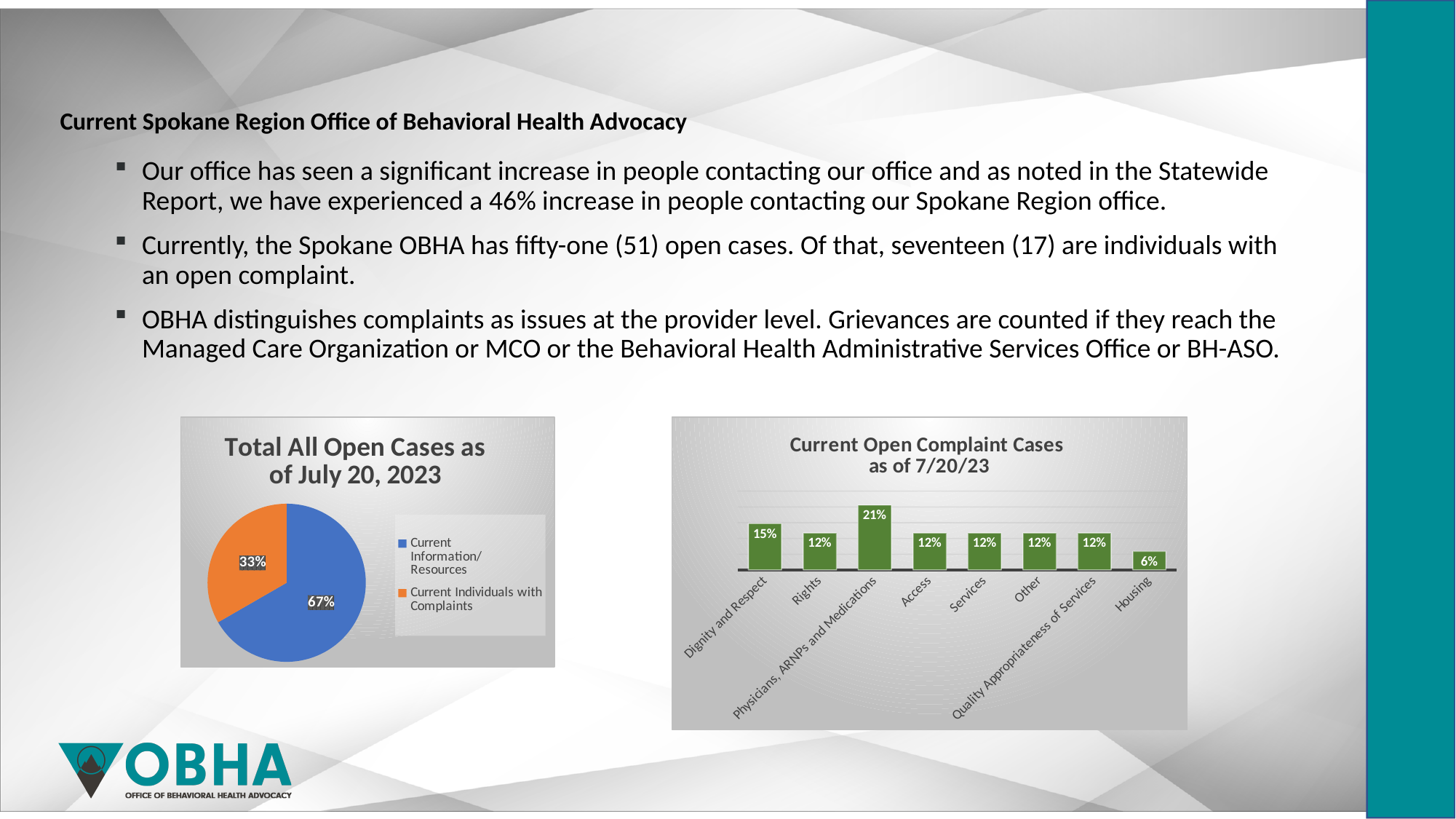
In the 'Current Open Complaint Cases as of 7/20/23' chart, which category has the highest value? Physicians, ARNPs and Medications How many categories are shown in the 'Current Open Complaint Cases as of 7/20/23' chart? 8 How many entries does the legend of the 'Total All Open Cases as of July 20, 2023' chart list? 2 What kind of chart is 'Total All Open Cases as of July 20, 2023'? Pie chart In the 'Total All Open Cases as of July 20, 2023' chart, what share of the pie is 'Current Individuals with Complaints'? 33% In the 'Current Open Complaint Cases as of 7/20/23' chart, what is the value for 'Dignity and Respect'? 15% In the 'Current Open Complaint Cases as of 7/20/23' chart, which category has the lowest value? Housing What kind of chart is 'Current Open Complaint Cases as of 7/20/23'? Bar chart In the 'Total All Open Cases as of July 20, 2023' chart, what share of the pie is 'Current Information/Resources'? 67% In the 'Current Open Complaint Cases as of 7/20/23' chart, which is larger: 'Dignity and Respect' or 'Rights'? Dignity and Respect In the 'Current Open Complaint Cases as of 7/20/23' chart, what is the difference between 'Physicians, ARNPs and Medications' and 'Housing'? 15% In the 'Current Open Complaint Cases as of 7/20/23' chart, what is the value for 'Physicians, ARNPs and Medications'? 21%